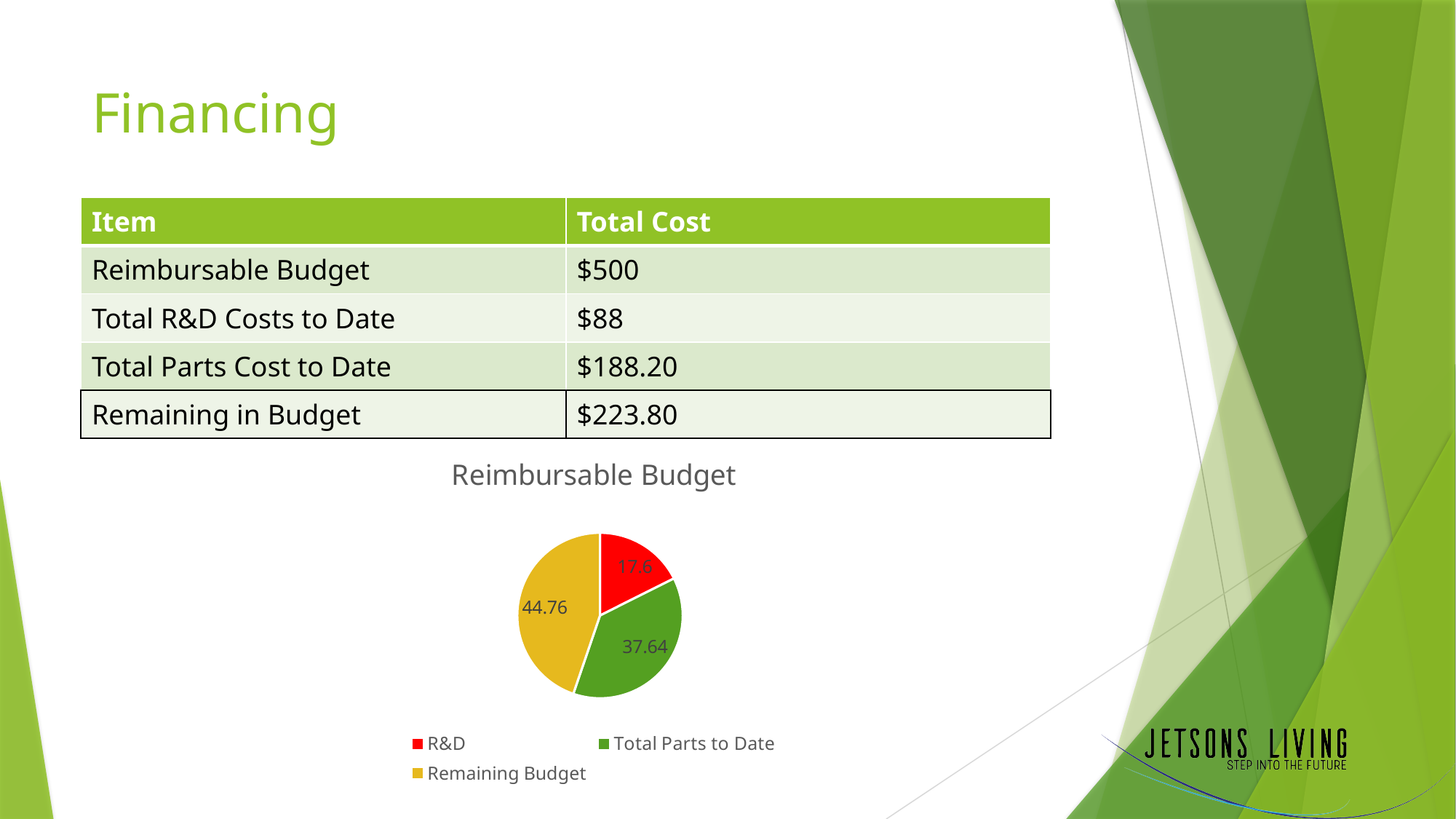
Which slice of the pie chart has the largest value? Remaining Budget What is the value shown for the Remaining Budget slice of the pie chart? 44.76 Which slice of the pie chart has the smallest value? R&D What is the difference between the Total Parts to Date slice and the R&D slice in the pie chart? 20.04 What is the value shown for the Total Parts to Date slice of the pie chart? 37.64 What type of chart is shown under the title "Reimbursable Budget"? pie chart Which is larger in the pie chart, the R&D slice or the Total Parts to Date slice? Total Parts to Date What is the difference between the Remaining Budget slice and the Total Parts to Date slice in the pie chart? 7.12 What is the value shown for the R&D slice of the pie chart? 17.6 What colour is the Remaining Budget slice in the pie chart? yellow How many slices does the pie chart have? 3 What is the title of the pie chart? Reimbursable Budget